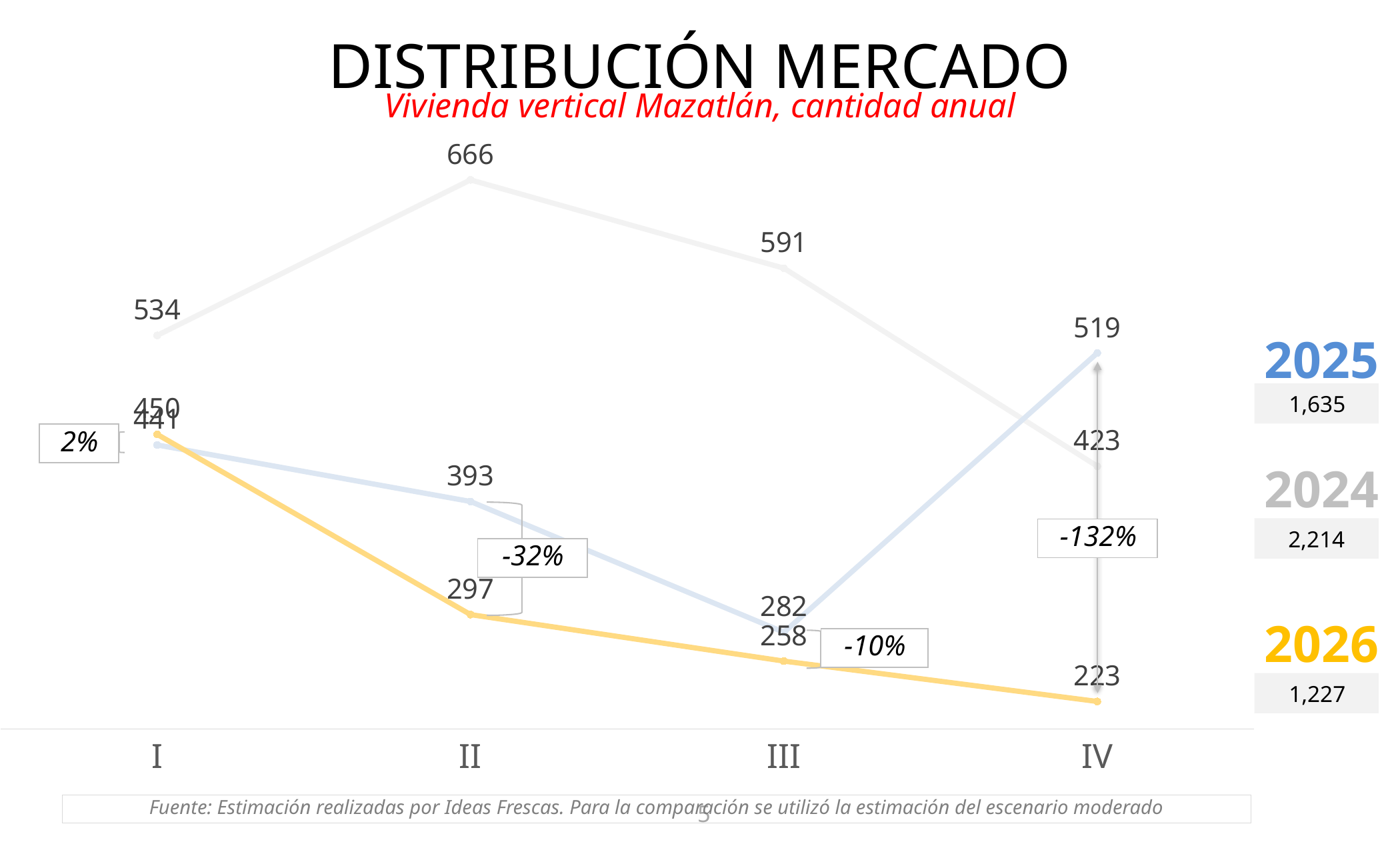
What kind of chart is shown on the slide? Line chart How many quarters are shown on the x axis? 4 In which quarter is the 2026 value lowest? IV How many series (years) does the chart show? 3 What is the value for 2024 in quarter II? 666 What is the value for 2025 in quarter IV? 519 What is the value for 2026 in quarter III? 258 In quarter II, which is larger: the 2025 value or the 2026 value? 2025 What annual total is shown for 2025? 1,635 In which quarter is the 2024 value highest? II What is the difference between the 2024 values in quarter II and quarter IV? 243 Do the 2026 values rise or fall from quarter I to quarter IV? Fall